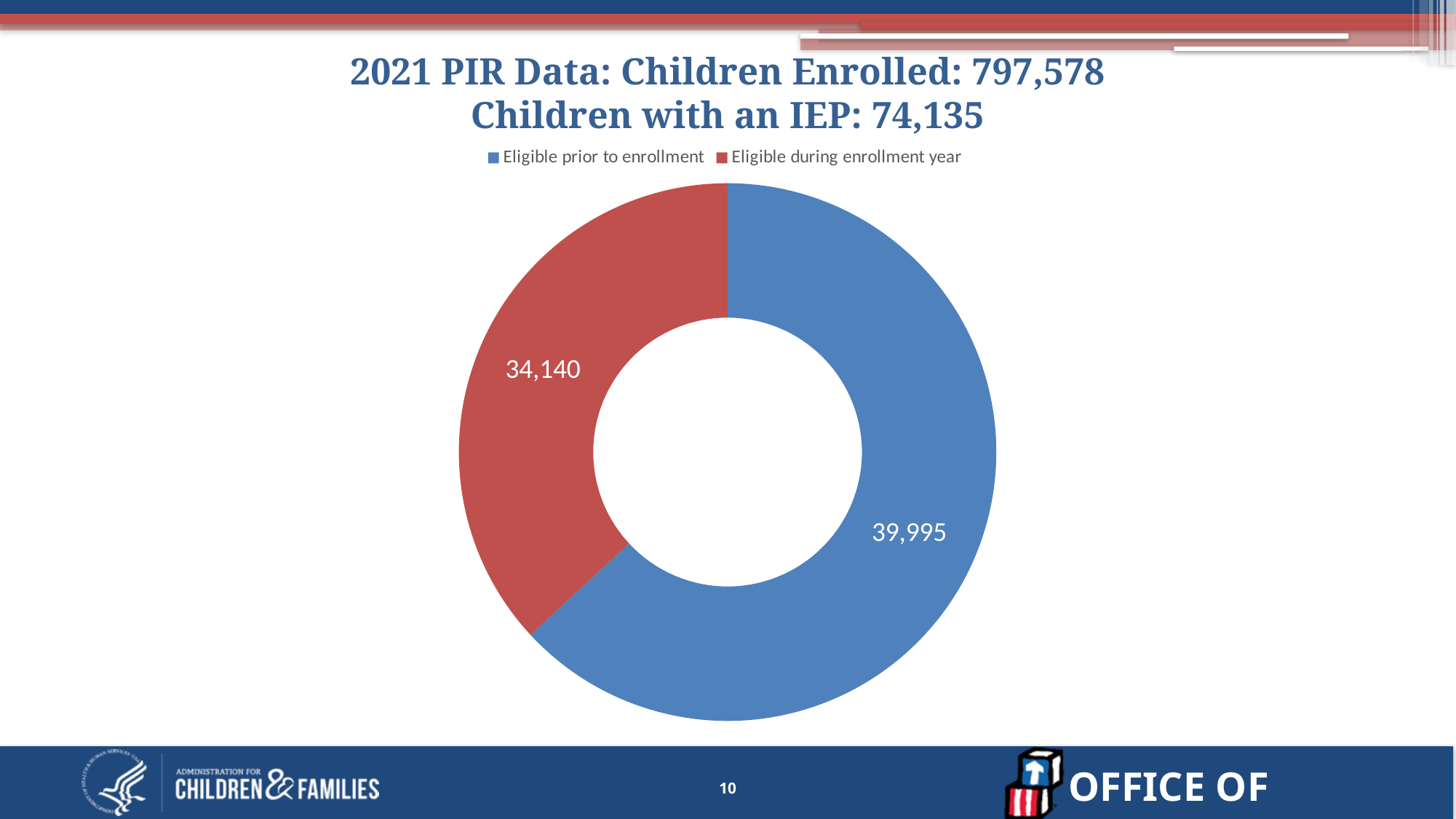
How many slices does the chart have? 2 Which is larger: Eligible prior to enrollment or Eligible during enrollment year? Eligible prior to enrollment Which category has the largest slice? Eligible prior to enrollment What is the value for Eligible prior to enrollment? 39,995 What colour is the Eligible during enrollment year slice? red What share of the total does Eligible prior to enrollment represent? 53.9% What is the value for Eligible during enrollment year? 34,140 What kind of chart is shown on the slide? doughnut chart What is the total of the two slices? 74,135 Which category has the smallest slice? Eligible during enrollment year How many entries does the legend list? 2 What is the difference between the Eligible prior to enrollment value and the Eligible during enrollment year value? 5,855